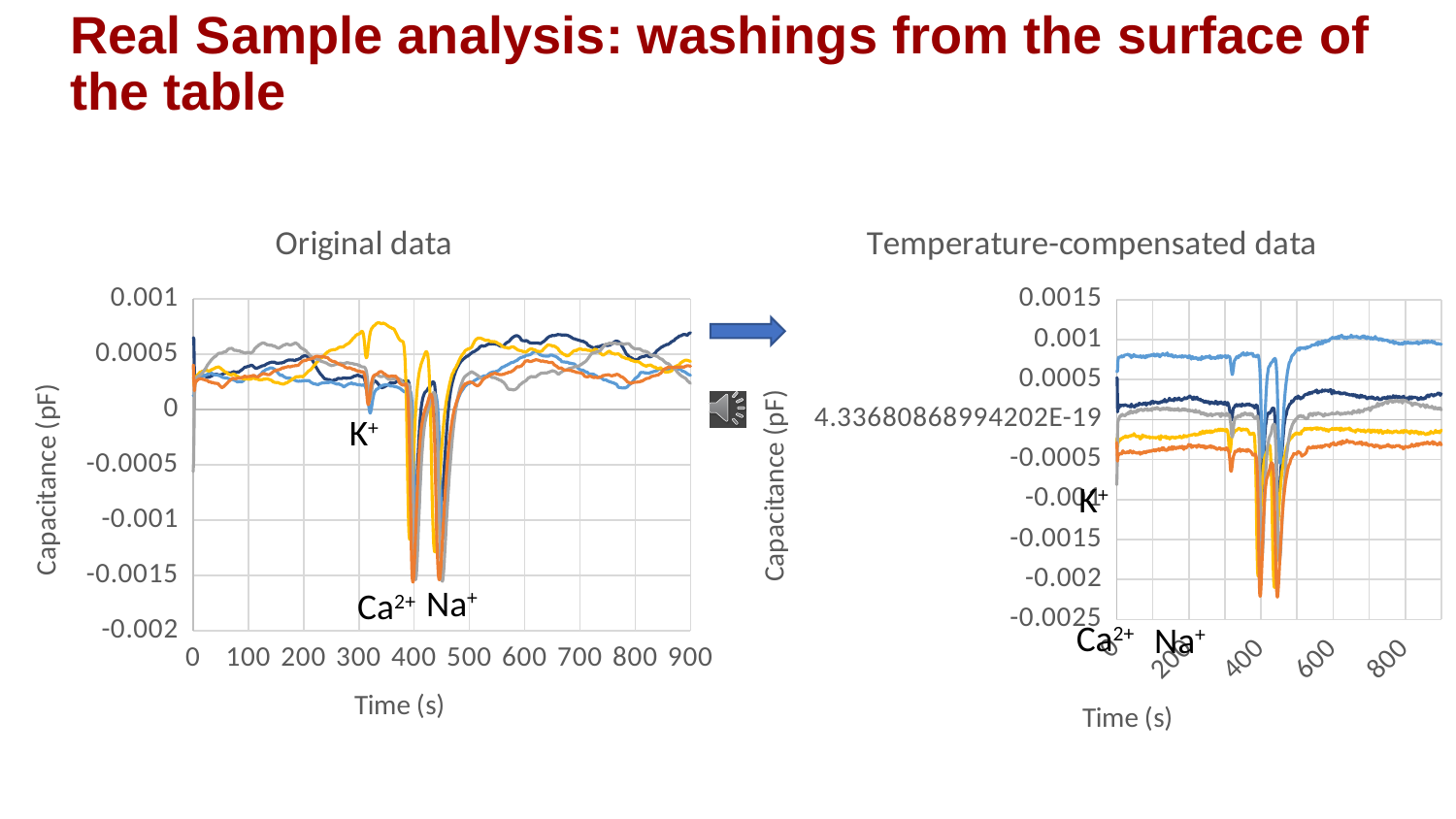
What is the highest tick value on the y-axis of the "Temperature-compensated data" chart? 0.0015 What value is printed on the y-axis of the "Temperature-compensated data" chart between 0.0005 and -0.0005? 4.33680868994202E-19 In the "Temperature-compensated data" chart, is the light blue line between 600 s and 800 s greater or less than 0.0005? greater In the "Temperature-compensated data" chart, is the lowest point of the dip near 400 s greater or less than -0.0015? less In the "Original data" chart, how many lines are plotted? 5 In the "Original data" chart, is the yellow line at about 300 s greater or less than 0.0005? greater What kind of chart is the "Original data" chart? line chart What are the titles of the two charts on the slide? Original data; Temperature-compensated data How many charts are shown on the slide? 2 Which ions are annotated on the "Original data" chart? K+, Ca2+, Na+ What is the largest tick value on the x-axis of the "Original data" chart? 900